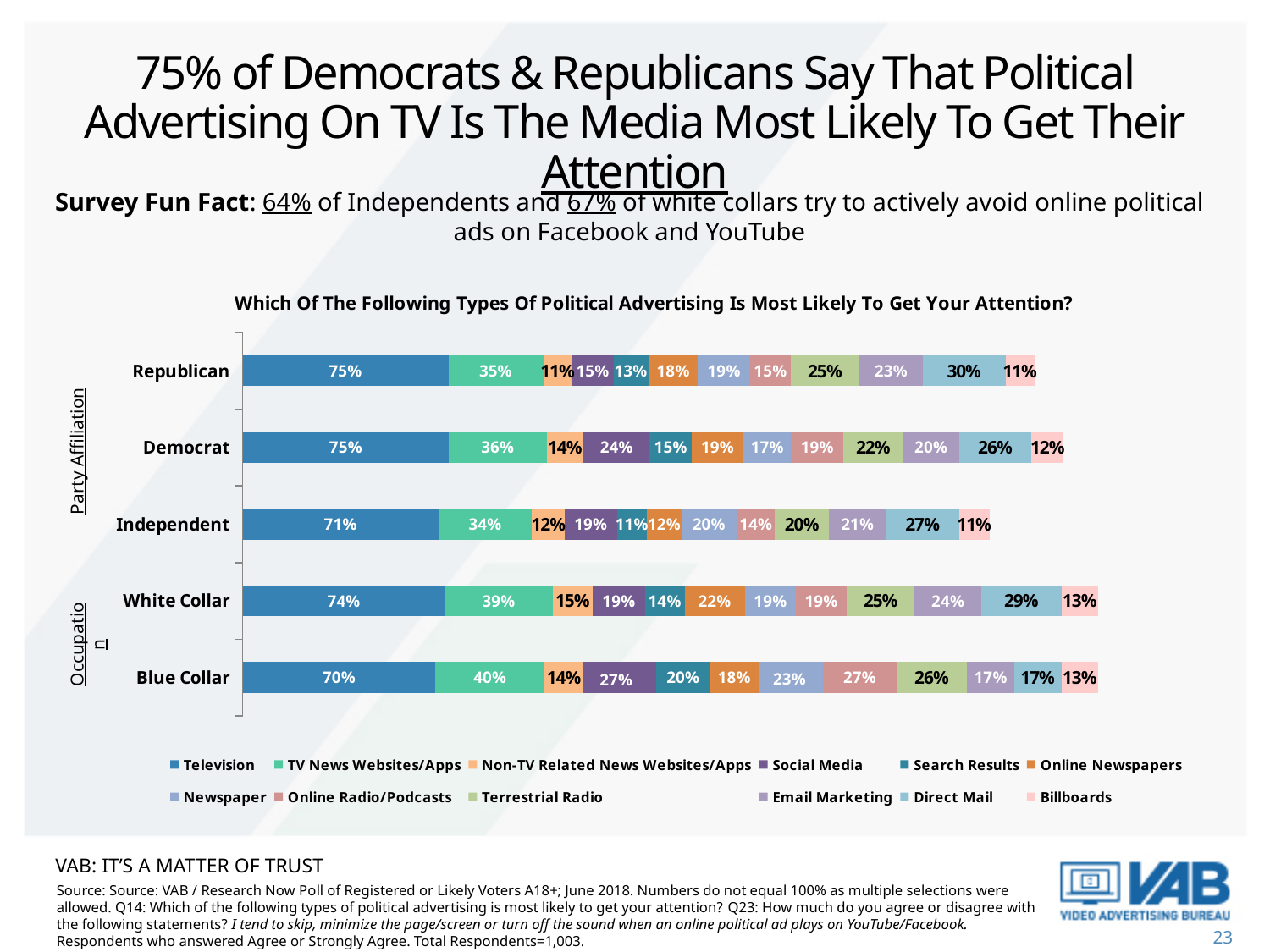
What percentage of Republicans say Television is the type of political advertising most likely to get their attention? 75% What type of chart is shown on the slide? Bar chart Which group has the highest TV News Websites/Apps value? Blue Collar How many series does the legend list? 12 What is the difference between the Television value for Democrats and the Television value for Independents? 4% What is the Social Media value for Blue Collar respondents? 27% Which group has the lowest Television value? Blue Collar What is the Direct Mail value for Independents? 27% How many respondent groups are shown on the chart? 5 Which is larger: the Social Media value for Democrats or the Social Media value for Republicans? Democrat Which series is shown in the legend immediately after Television? TV News Websites/Apps What is the TV News Websites/Apps value for White Collar respondents? 39%